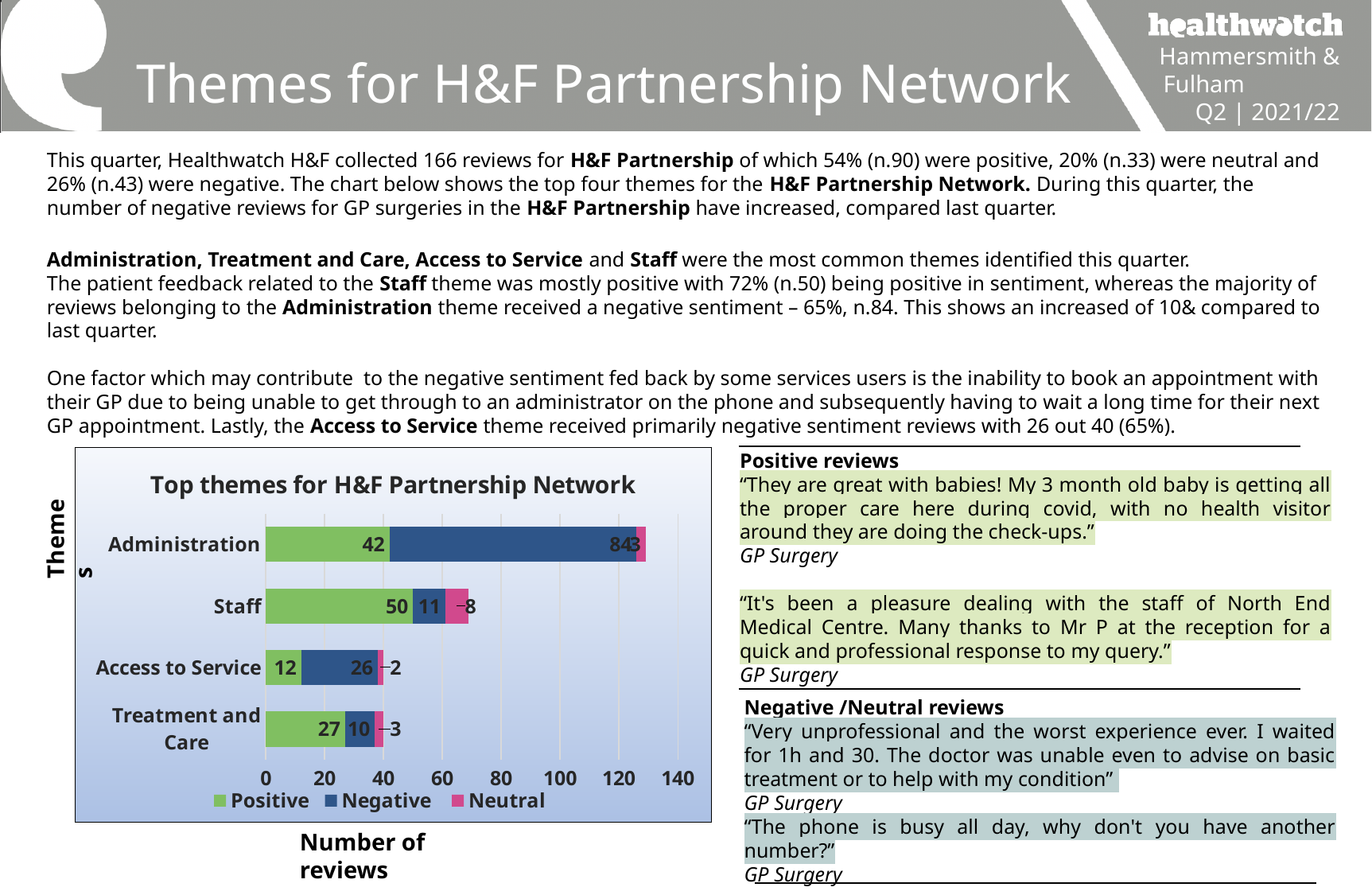
What is the Neutral value for Access to Service? 2 What type of chart is shown on the slide? Bar chart How many theme categories are plotted in the chart? 4 Is the Negative value for Access to Service larger than the Negative value for Staff? Yes Which theme has the lowest Positive value? Access to Service What is the difference between the Negative and Positive values for Administration? 42 What is the Negative value for Treatment and Care? 10 What is the total number of reviews in the Staff bar? 69 Which theme has the highest Positive value? Staff What is the Negative value for Administration? 84 How many series does the chart legend list? 3 What is the Positive value for Staff? 50